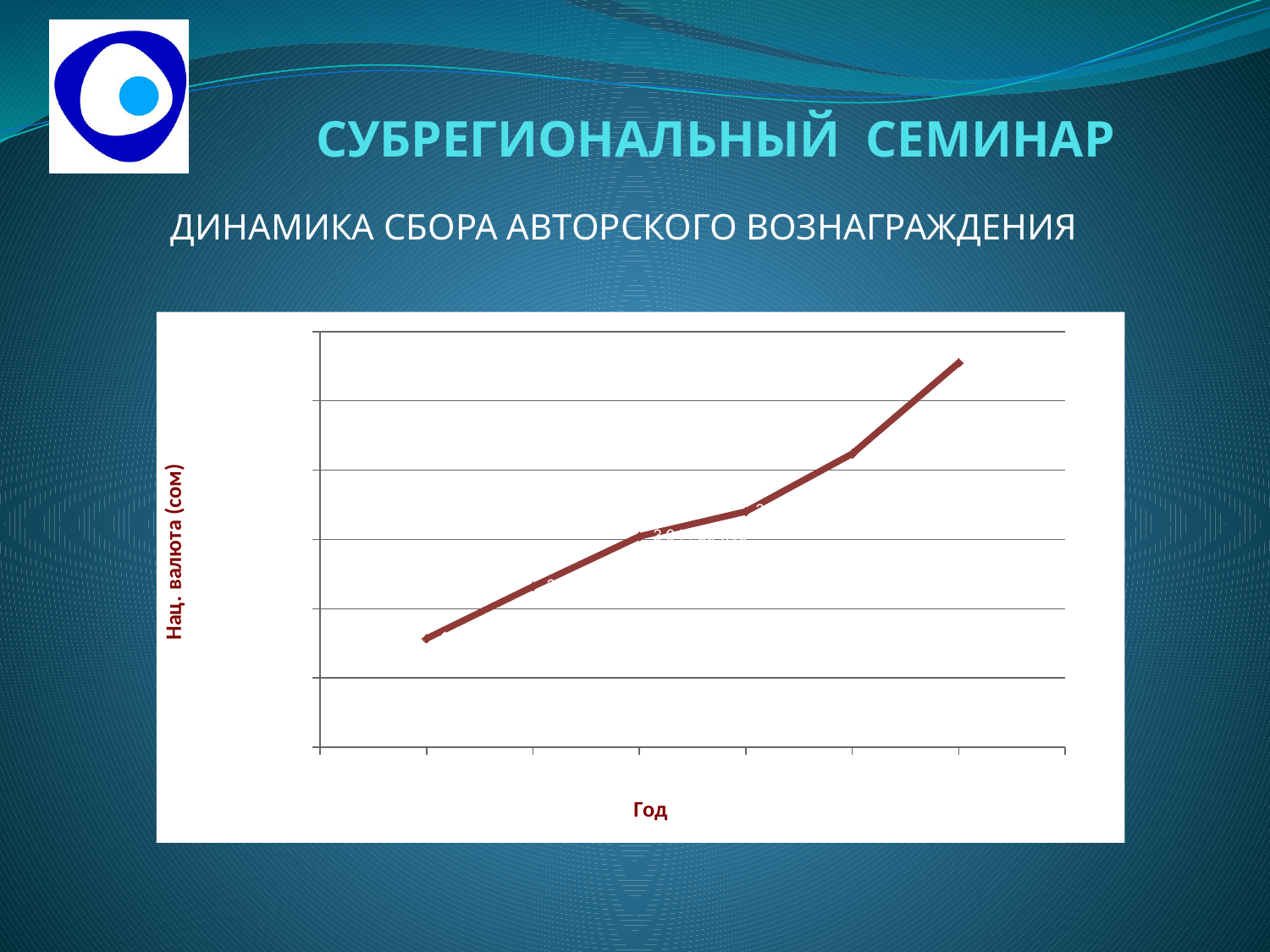
Is the lowest value on the line at the leftmost or the rightmost point? leftmost How many lines (series) are plotted on the chart? 1 What is the title of the vertical axis? Нац. валюта (сом) Do the values rise or fall from left to right along the x axis? rise Is the highest value on the line at the leftmost or the rightmost point? rightmost Which is larger, the value at the first (leftmost) point or the value at the last (rightmost) point? the last (rightmost) point How many data points are plotted on the line? 6 What kind of chart is shown on the slide? line chart What is the title of the horizontal axis? Год